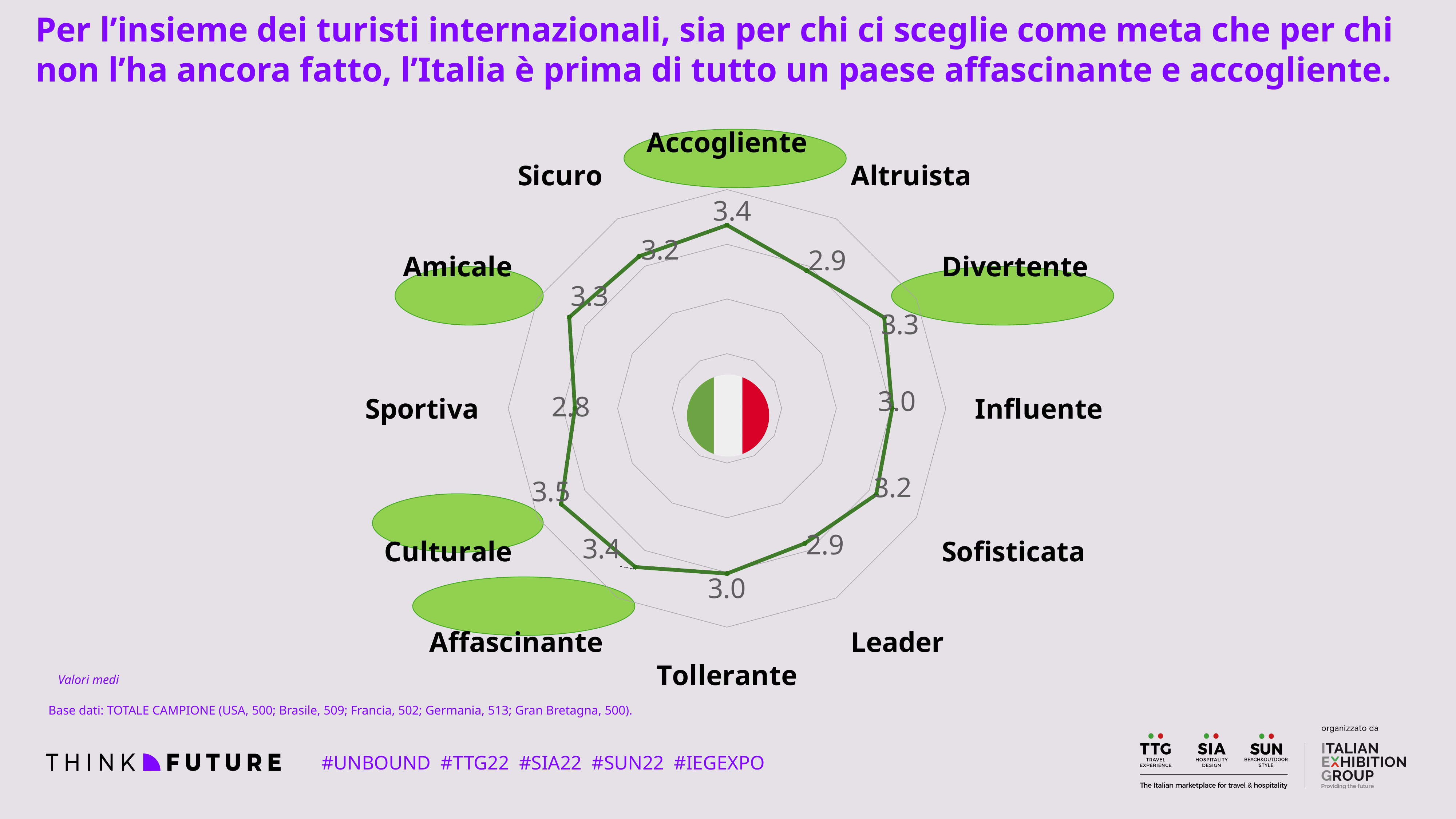
Which attribute has the highest value? Culturale What is the value for Tollerante? 3.0 What is the difference between the values for Culturale and Sportiva? 0.7 What is the value for Accogliente? 3.4 What is the value for Divertente? 3.3 What is shown at the centre of the radar chart? The Italian flag What is the value for Sportiva? 2.8 Which attribute has the lowest value? Sportiva What type of chart is shown on the slide? Radar chart Which has a higher value, Affascinante or Leader? Affascinante What is the value for Culturale? 3.5 How many categories (attributes) are plotted on the radar chart? 12